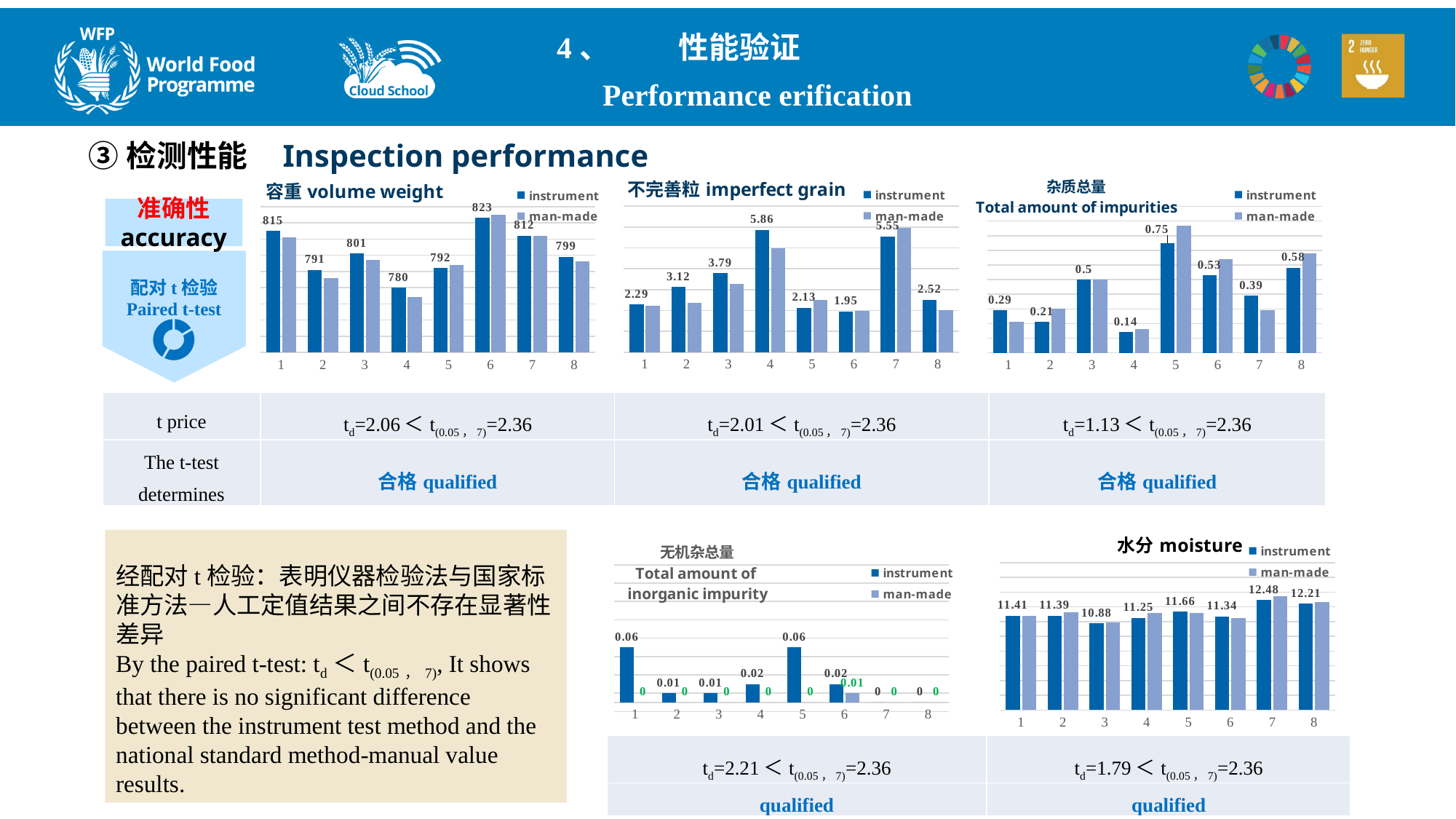
In the imperfect grain chart, which category has the lowest labelled instrument value? 6 In the Total amount of impurities chart, what is the difference between the labelled instrument values for category 5 and category 4? 0.61 In the imperfect grain chart, what is the instrument value for category 4? 5.86 In the volume weight chart, which is larger, the instrument value for category 3 or for category 5? category 3 In the moisture chart, which category has the highest labelled value? 7 In the Total amount of impurities chart, which category has the highest labelled instrument value? 5 In the moisture chart, what is the labelled value for category 3? 10.88 How many series does the legend of the moisture chart list? 2 In the volume weight chart, which category has the lowest labelled instrument value? 4 How many categories are shown on the x axis of the imperfect grain chart? 8 In the Total amount of inorganic impurity chart, what is the man-made value for category 6? 0.01 In the volume weight chart, what is the instrument value for category 6? 823